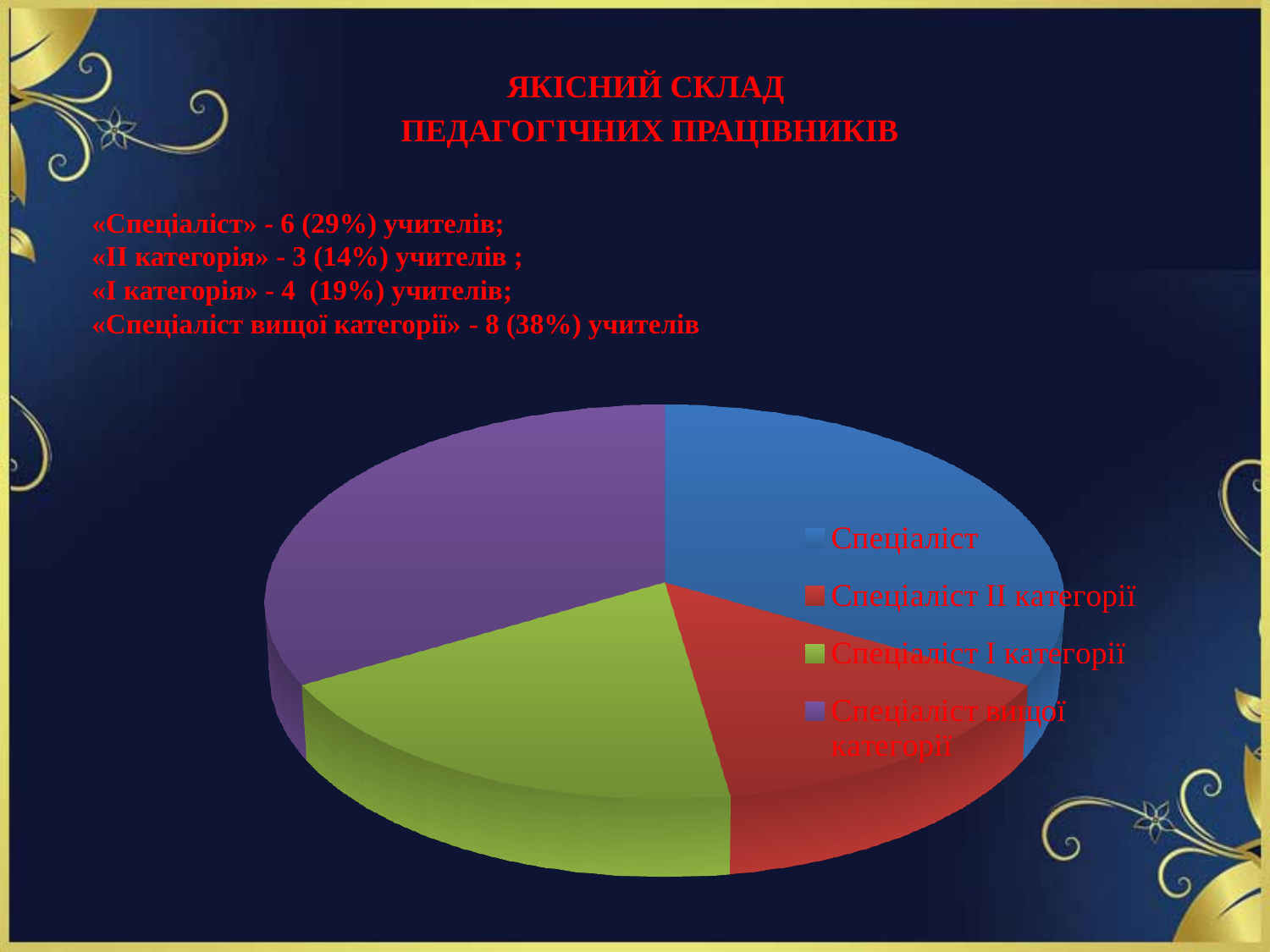
How many slices does the pie chart have? 4 Which slice is larger in the pie chart: Спеціаліст or Спеціаліст І категорії? Спеціаліст What kind of chart is shown on the slide? pie chart Which slice is larger in the pie chart: Спеціаліст вищої категорії or Спеціаліст ІІ категорії? Спеціаліст вищої категорії What is the title of the slide containing the pie chart? ЯКІСНИЙ СКЛАД ПЕДАГОГІЧНИХ ПРАЦІВНИКІВ According to the slide, what share of teachers are «Спеціаліст вищої категорії»? 38% What colour is the slice for Спеціаліст вищої категорії in the pie chart? purple According to the slide, how many teachers are in the «І категорія» group? 4 Which category has the smallest slice in the pie chart? Спеціаліст ІІ категорії How many entries does the legend of the pie chart list? 4 According to the slide, what share of teachers are «Спеціаліст»? 29%